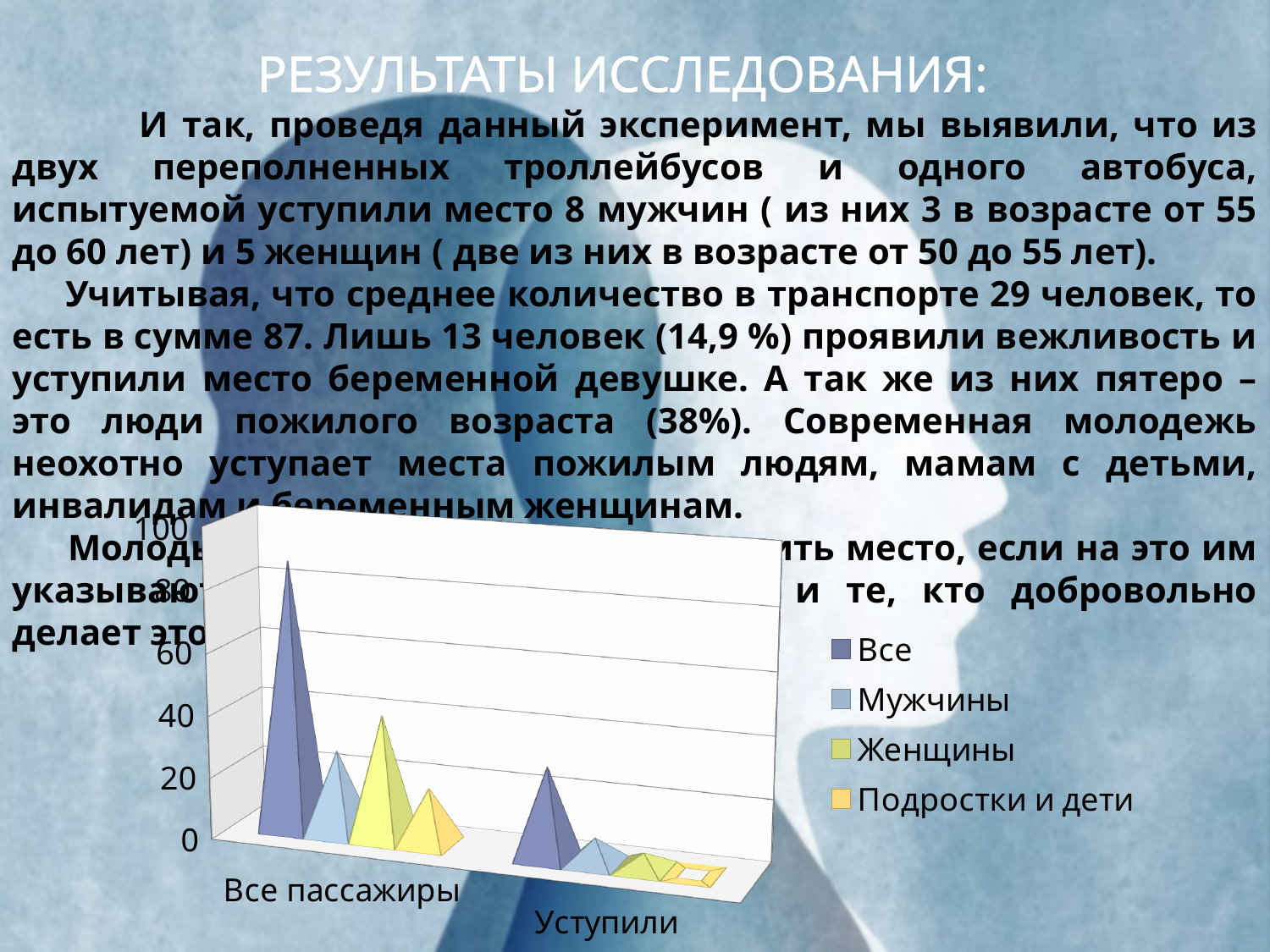
For the Все series, which category has the larger value: Все пассажиры or Уступили? Все пассажиры Is the value for Все in the Уступили category greater or less than 40? less Is the value for Женщины in the Все пассажиры category greater or less than 20? greater Is the value for Все in the Все пассажиры category greater or less than 60? greater Which series is listed last in the chart legend? Подростки и дети What are the two categories on the x axis of the chart? Все пассажиры, Уступили Which series has the highest value in the Все пассажиры category? Все Which series has the lowest value in the Уступили category? Подростки и дети Do the values for each series rise or fall from Все пассажиры to Уступили? fall How many categories are shown on the x axis of the chart? 2 How many series does the chart legend list? 4